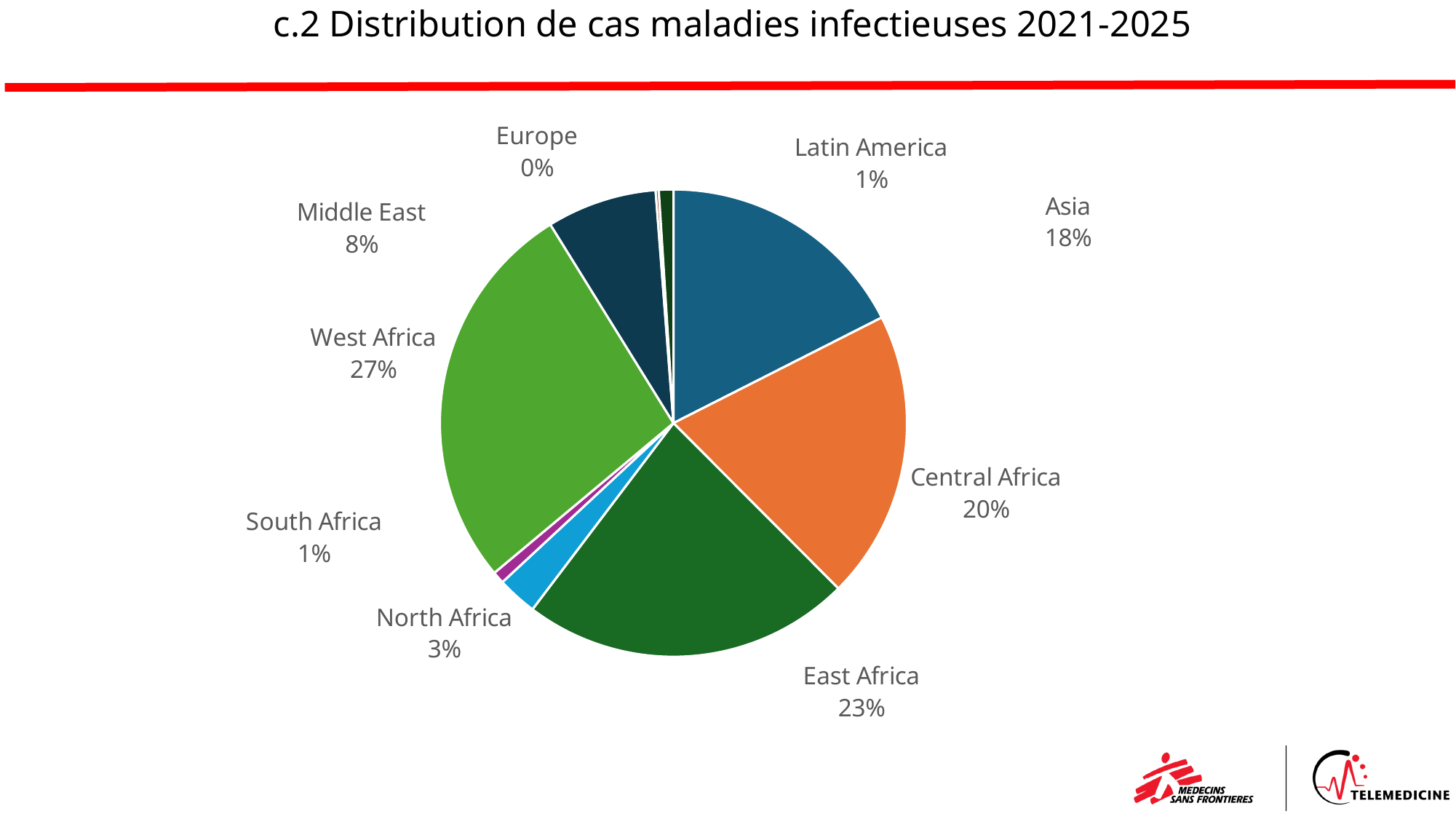
Which is larger, the share for Central Africa or the share for Asia? Central Africa What is the value shown for East Africa? 23% What is the difference between the shares of East Africa and North Africa? 20 percentage points What is the value shown for Middle East? 8% What is the title of the chart? c.2 Distribution de cas maladies infectieuses 2021-2025 What is the difference between the shares of West Africa and Central Africa? 7 percentage points Which region has the largest slice of the pie? West Africa How many regions are shown on the pie chart? 9 What is the value shown for Asia? 18% What kind of chart is shown on the slide? Pie chart What share of the pie does West Africa account for? 27% Which region has the smallest share shown on the chart? Europe